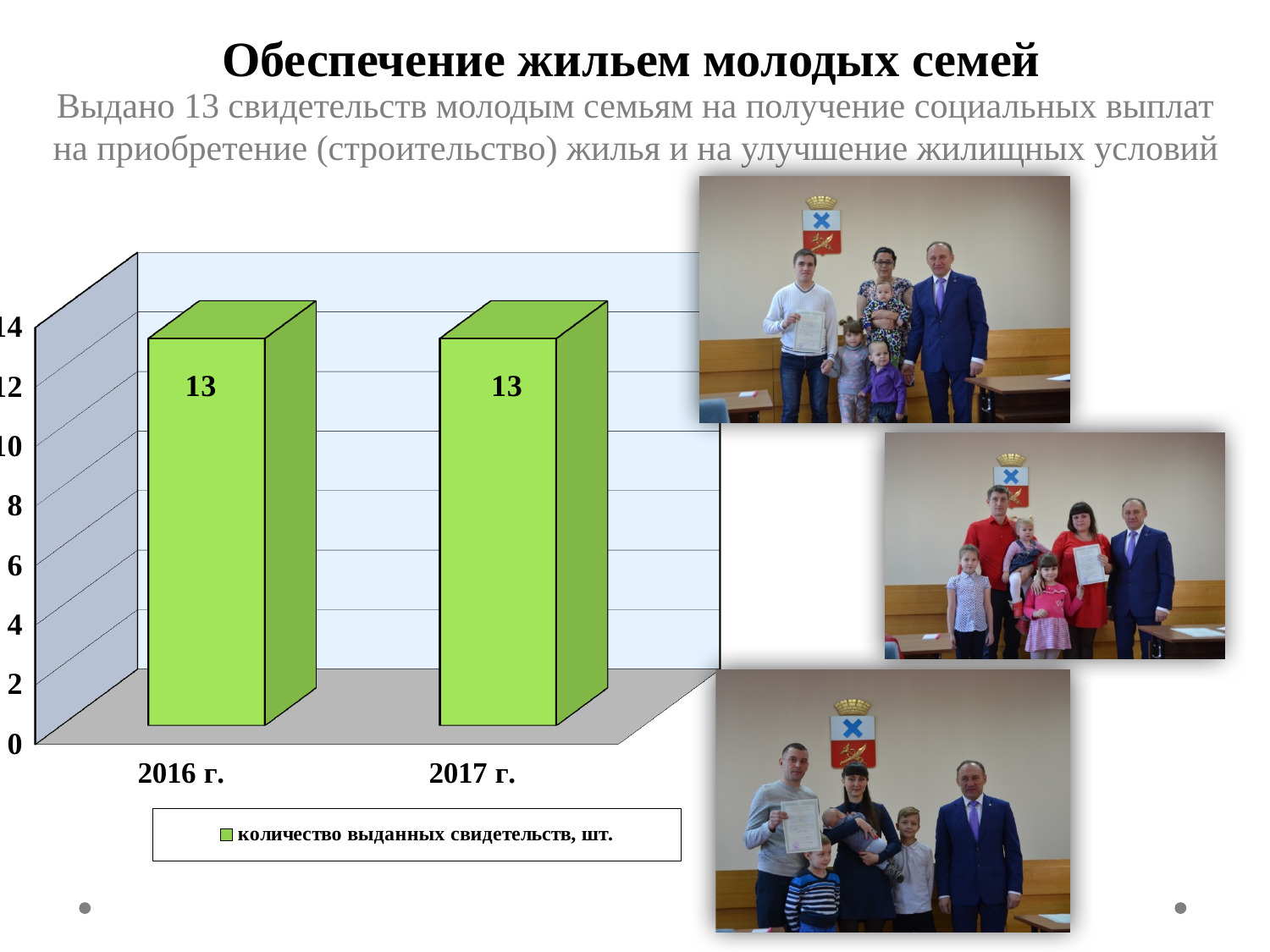
What colour are the bars in the chart? green Do the values rise, fall or stay the same from 2016 г. to 2017 г.? stay the same How many categories are shown on the x axis? 2 What kind of chart is shown on the slide? bar chart What is the difference between the values for 2016 г. and 2017 г.? 0 What is the value for 2016 г.? 13 What is the series name shown in the legend? количество выданных свидетельств, шт. Is the value for 2017 г. greater or less than 14? less Is the value for 2016 г. greater or less than 10? greater What is the value for 2017 г.? 13 How many series does the legend list? 1